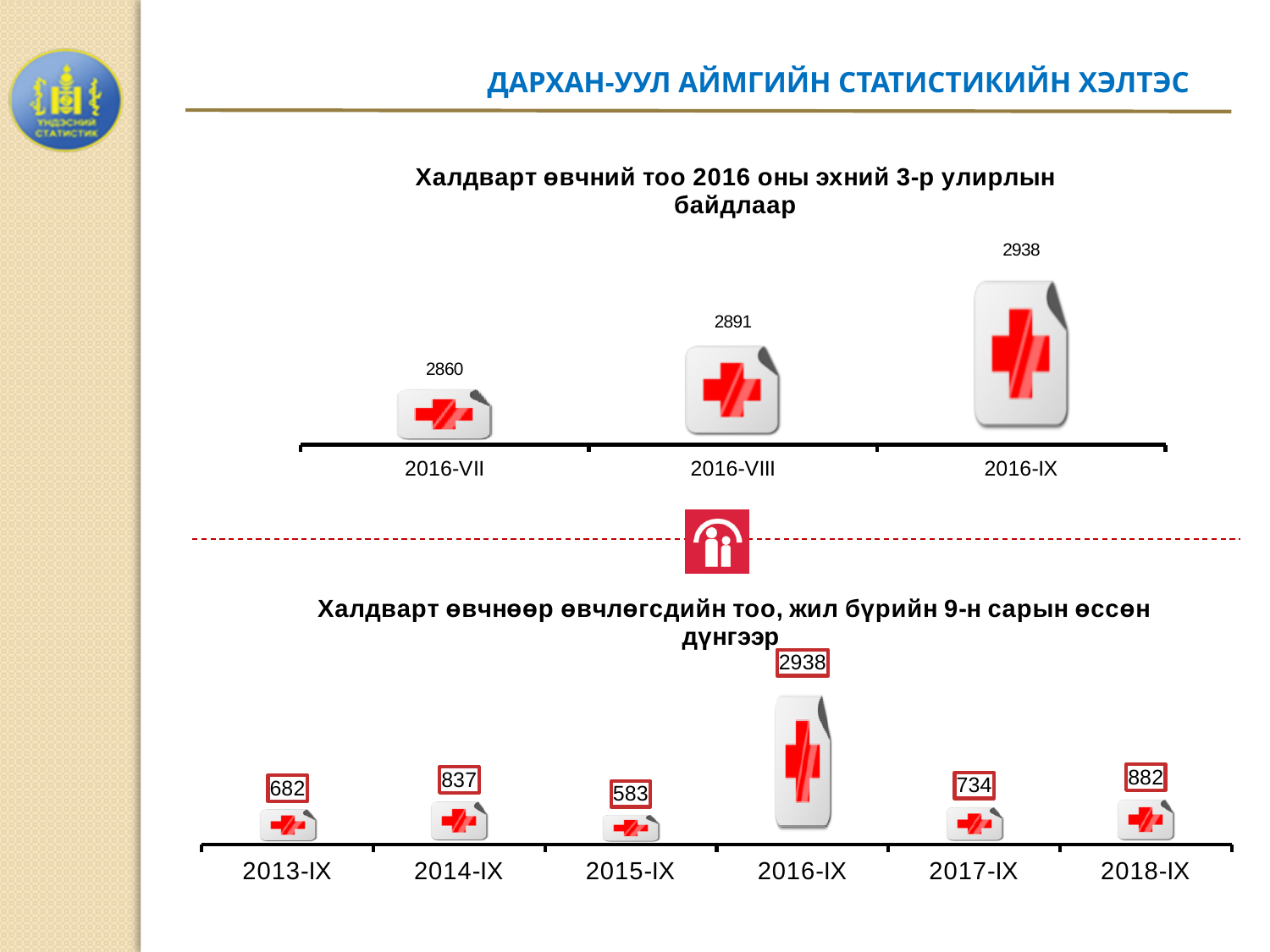
In the bottom chart, what is the difference between the values for 2018-IX and 2013-IX? 200 In the bottom chart, what is the value for 2018-IX? 882 In the bottom chart, which is larger, the value for 2014-IX or 2017-IX? 2014-IX In the top chart, what is the difference between the values for 2016-IX and 2016-VII? 78 In the top chart, how many months are shown? 3 In the top chart, what is the value for 2016-VII? 2860 In the top chart, do the values rise or fall from 2016-VII to 2016-IX? rise In the bottom chart, what is the value for 2015-IX? 583 In the top chart, which month has the highest value? 2016-IX In the top chart, what is the value for 2016-VIII? 2891 In the bottom chart, which year has the lowest value? 2015-IX In the bottom chart, which year has the highest value? 2016-IX